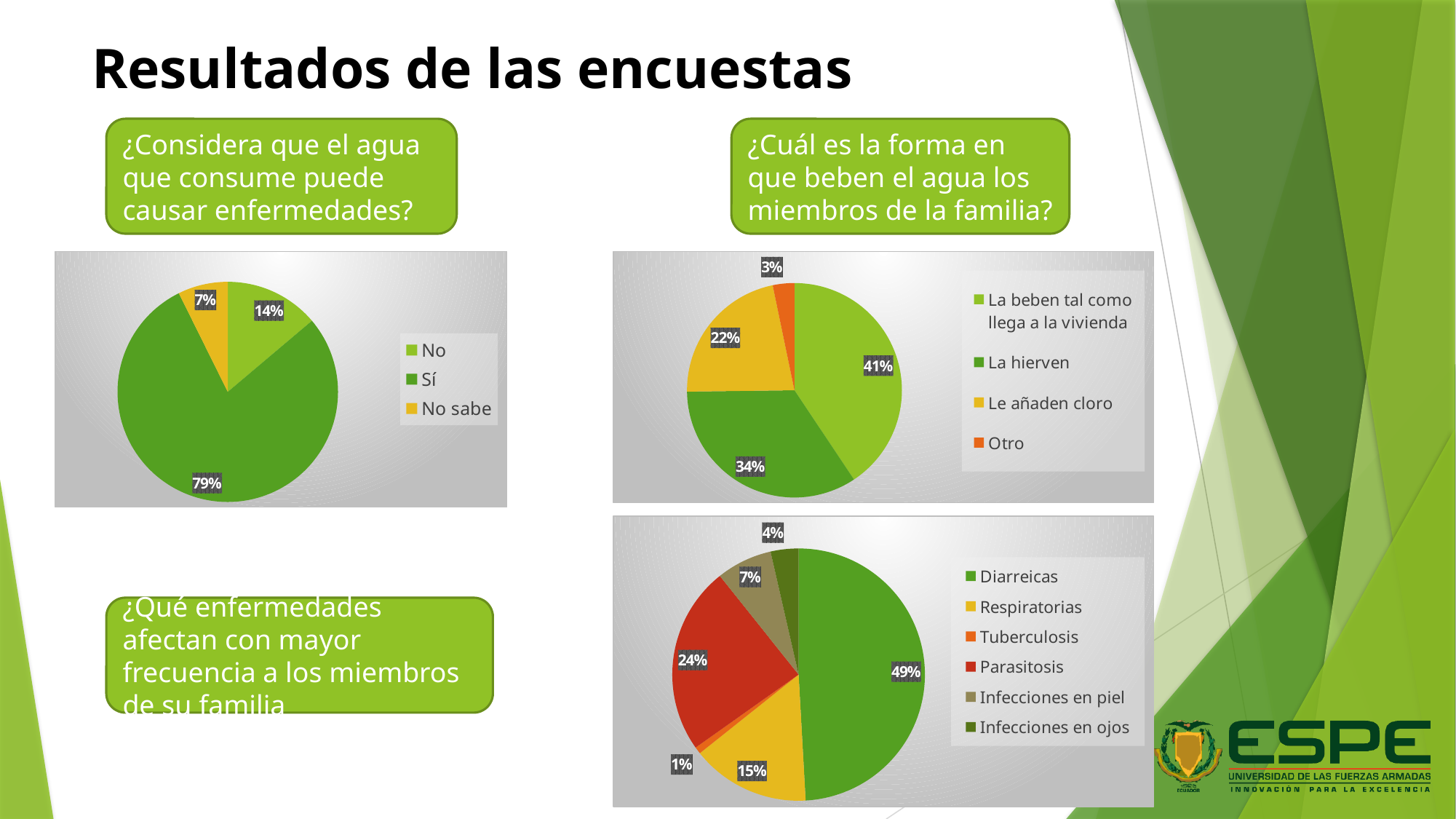
What type of chart is used for the bottom-right chart about enfermedades? Pie chart In the top-right pie chart (¿Cuál es la forma en que beben el agua los miembros de la familia?), which category has the largest share? La beben tal como llega a la vivienda In the top-left pie chart (¿Considera que el agua que consume puede causar enfermedades?), what is the difference in percentage points between Sí and No? 65 In the top-right pie chart (¿Cuál es la forma en que beben el agua los miembros de la familia?), what percentage corresponds to La hierven? 34% In the bottom-right pie chart (¿Qué enfermedades afectan con mayor frecuencia a los miembros de su familia), what percentage corresponds to Parasitosis? 24% In the top-right pie chart (¿Cuál es la forma en que beben el agua los miembros de la familia?), which is larger: Le añaden cloro or La hierven? La hierven In the top-left pie chart (¿Considera que el agua que consume puede causar enfermedades?), what percentage answered Sí? 79% In the top-left pie chart (¿Considera que el agua que consume puede causar enfermedades?), how many categories does the legend list? 3 In the top-left pie chart (¿Considera que el agua que consume puede causar enfermedades?), which category has the smallest share? No sabe In the bottom-right pie chart (¿Qué enfermedades afectan con mayor frecuencia a los miembros de su familia), how many categories does the legend list? 6 In the top-right pie chart (¿Cuál es la forma en que beben el agua los miembros de la familia?), what percentage corresponds to Otro? 3% In the bottom-right pie chart (¿Qué enfermedades afectan con mayor frecuencia a los miembros de su familia), which category has the smallest share? Tuberculosis